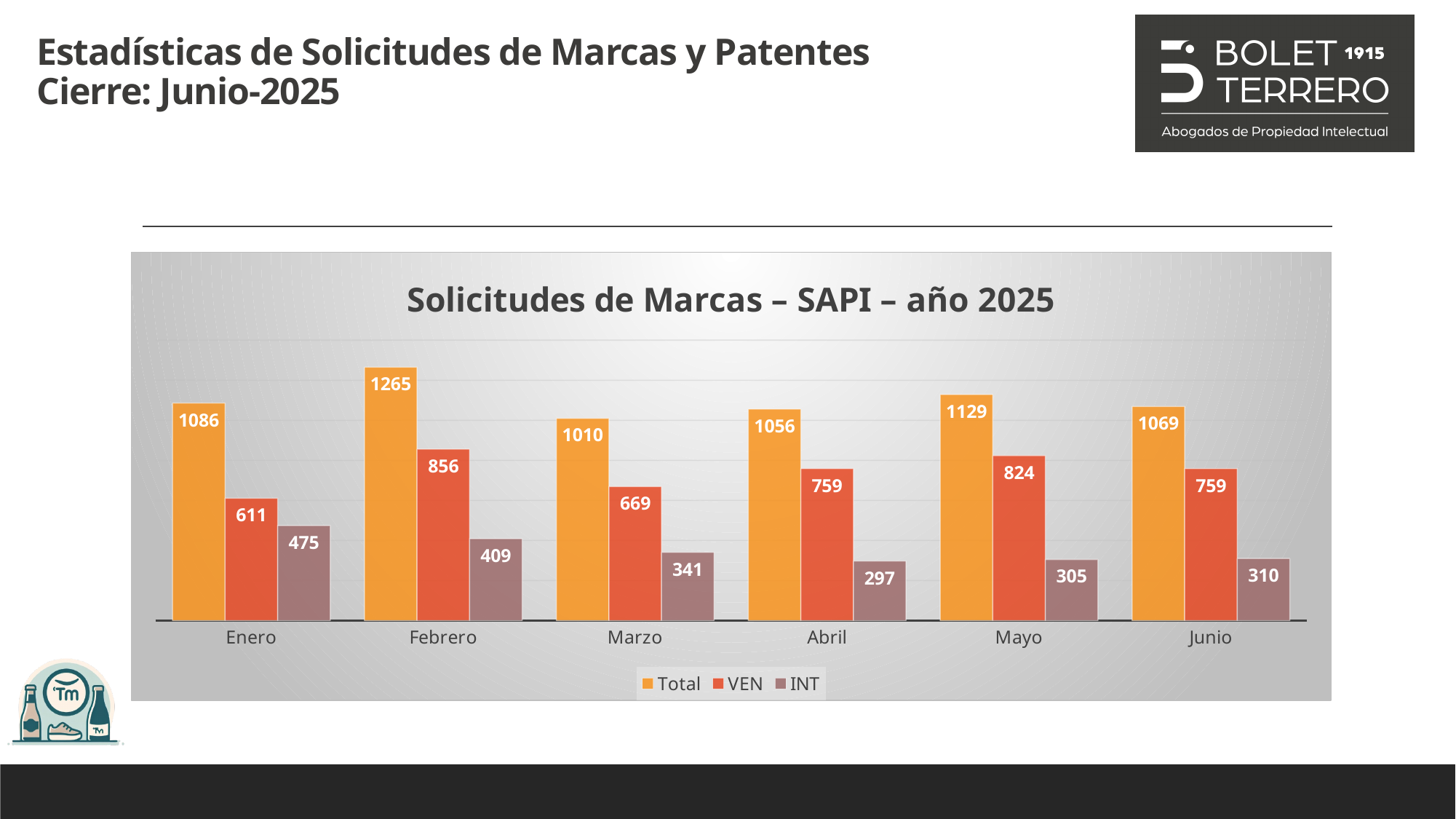
How many months are shown on the x axis? 6 What is the difference between the Total values for Febrero and Marzo? 255 What is the title of the chart? Solicitudes de Marcas – SAPI – año 2025 What is the INT value for Abril? 297 Which month has the lowest INT value? Abril How many series does the legend list? 3 What is the Total value for Febrero? 1265 What kind of chart is shown? Bar chart What is the difference between the VEN and INT values for Junio? 449 What is the VEN value for Mayo? 824 Which is larger, the VEN value for Enero or the VEN value for Marzo? Marzo Which month has the highest Total value? Febrero